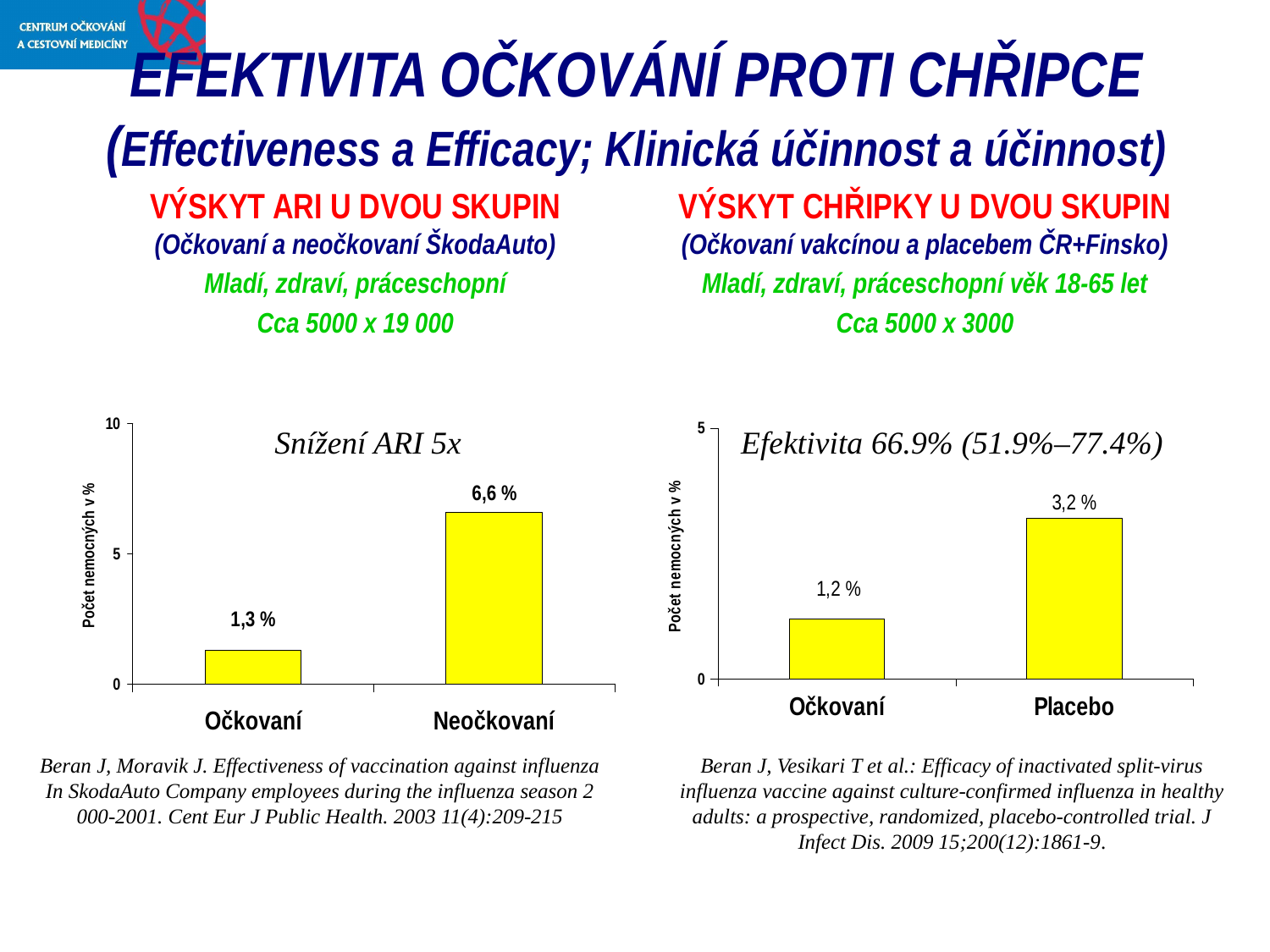
In the right chart (Výskyt chřipky u dvou skupin), what is the value for Placebo? 3,2 % In the left chart (Výskyt ARI u dvou skupin), what is the difference between the values for Neočkovaní and Očkovaní? 5,3 % In the left chart (Výskyt ARI u dvou skupin), what is the value for Očkovaní? 1,3 % In the right chart (Výskyt chřipky u dvou skupin), which is larger, the value for Očkovaní or for Placebo? Placebo In the right chart (Výskyt chřipky u dvou skupin), which category has the lowest value? Očkovaní In the left chart (Výskyt ARI u dvou skupin), which category has the highest value? Neočkovaní What kind of chart is the right chart (Výskyt chřipky u dvou skupin)? bar chart In the right chart (Výskyt chřipky u dvou skupin), what is the difference between the values for Placebo and Očkovaní? 2,0 % In the left chart (Výskyt ARI u dvou skupin), what is the value for Neočkovaní? 6,6 % In the left chart (Výskyt ARI u dvou skupin), is the value for Neočkovaní greater or less than 5? greater In the right chart (Výskyt chřipky u dvou skupin), what is the value for Očkovaní? 1,2 % How many categories does the left chart (Výskyt ARI u dvou skupin) show? 2